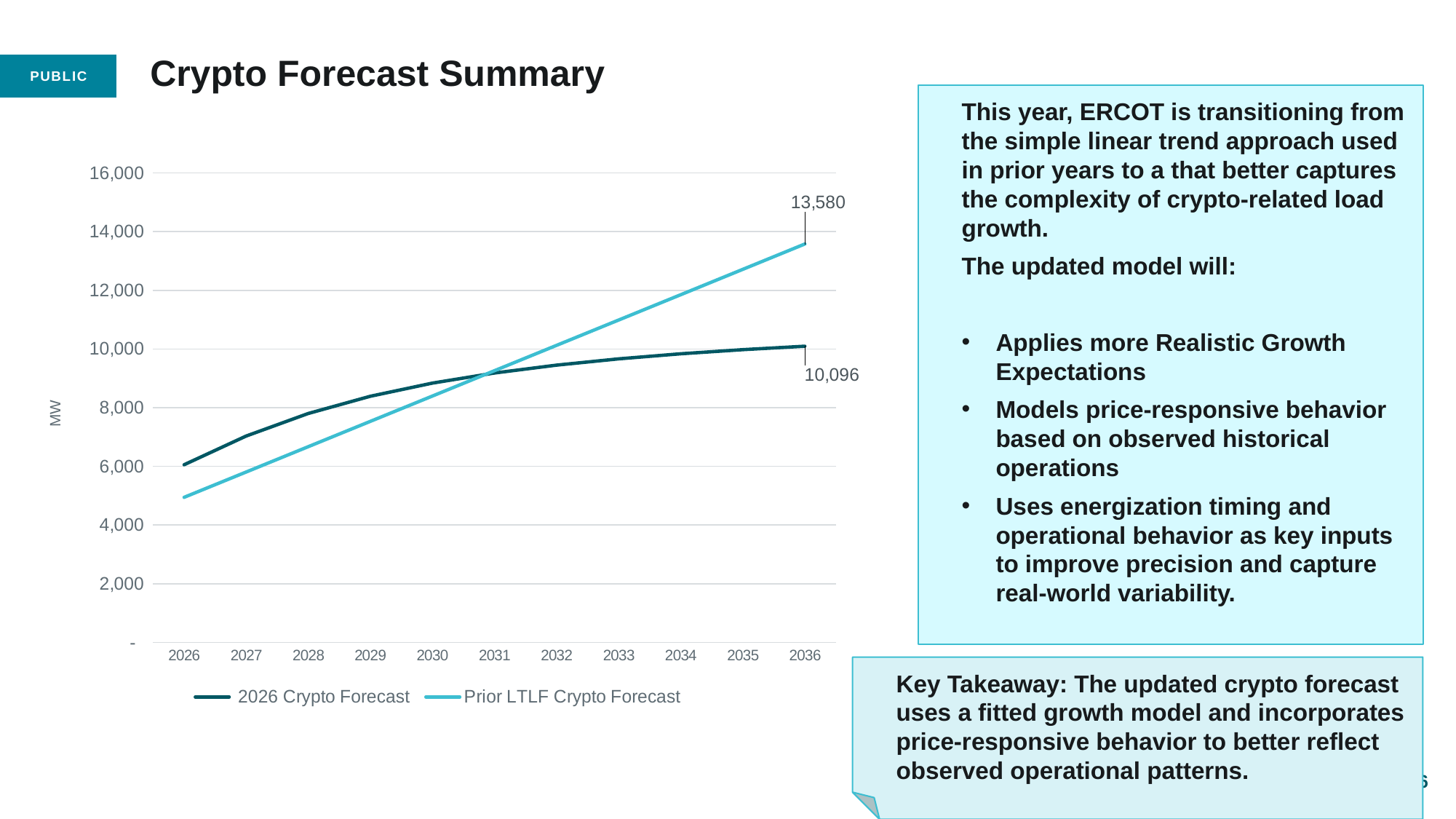
How many series does the chart legend list? 2 What unit is shown on the y axis of the chart? MW What is the value of the Prior LTLF Crypto Forecast in 2036? 13,580 What is the difference between the Prior LTLF Crypto Forecast and the 2026 Crypto Forecast in 2036? 3,484 Is the value for the Prior LTLF Crypto Forecast in 2026 greater or less than 6,000? less In 2036, which series has the higher value: the 2026 Crypto Forecast or the Prior LTLF Crypto Forecast? Prior LTLF Crypto Forecast What is the value of the 2026 Crypto Forecast in 2036? 10,096 What kind of chart is shown on the slide? line chart Is the value for the 2026 Crypto Forecast in 2026 greater or less than 8,000? less How many years are shown along the x axis of the chart? 11 Does the 2026 Crypto Forecast line rise or fall from 2026 to 2036? rises In 2026, which series has the higher value: the 2026 Crypto Forecast or the Prior LTLF Crypto Forecast? 2026 Crypto Forecast